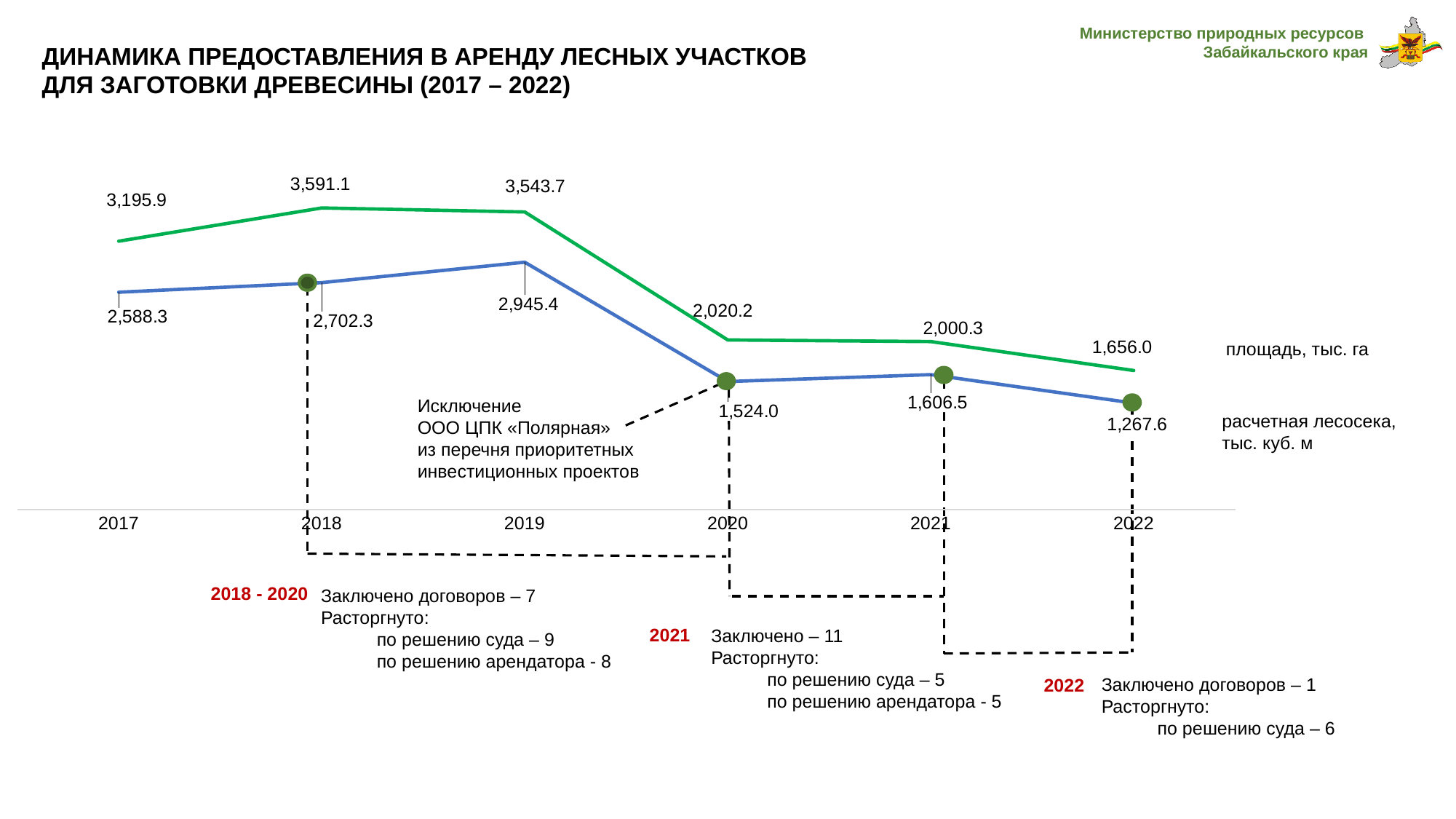
In which year is площадь, тыс. га highest? 2018 What is the value of площадь, тыс. га for 2018? 3,591.1 In which year is расчетная лесосека, тыс. куб. м highest? 2019 How many years are shown on the x axis of the chart? 6 What is the difference between расчетная лесосека, тыс. куб. м in 2019 and in 2020? 1,421.4 What is the value of расчетная лесосека, тыс. куб. м for 2020? 1,524.0 How many series does the chart plot? 2 What kind of chart is shown on the slide? Line chart In which year is расчетная лесосека, тыс. куб. м lowest? 2022 What is the value of площадь, тыс. га for 2022? 1,656.0 By how much did площадь, тыс. га change from 2017 to 2018? 395.2 Which is larger: площадь, тыс. га in 2019 or in 2020? 2019